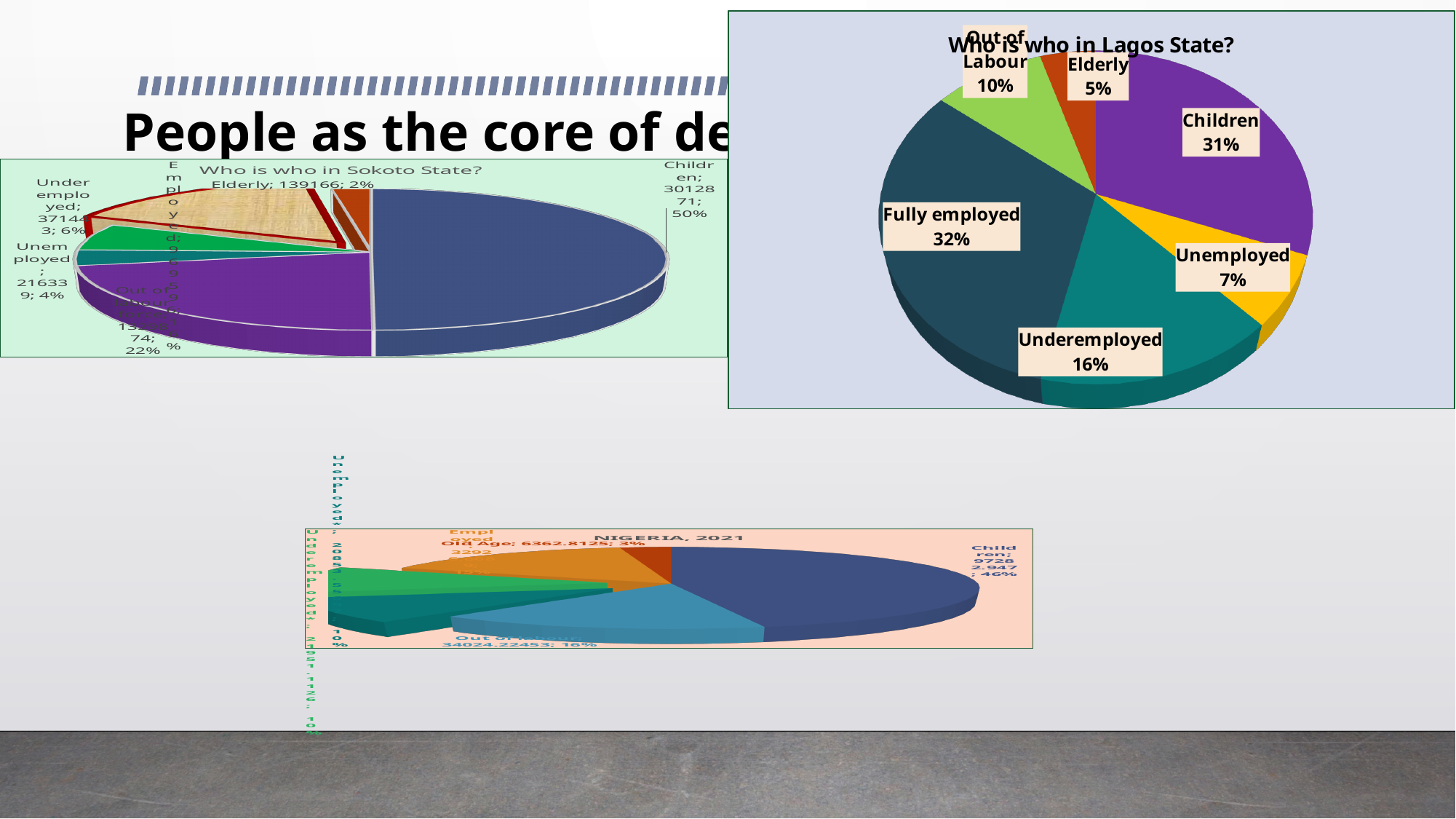
In the 'Who is who in Lagos State?' chart, what is the difference in percentage points between Fully employed and Underemployed? 16 In the 'Who is who in Lagos State?' chart, what share is labelled for Children? 31% In the 'Who is who in Lagos State?' chart, what share is labelled for Underemployed? 16% In the 'Who is who in Lagos State?' chart, which category has the smallest share? Elderly In the 'Who is who in Lagos State?' chart, which is larger, Out of Labour or Unemployed? Out of Labour In the 'NIGERIA, 2021' chart, what share is labelled for Children? 46% In the 'NIGERIA, 2021' chart, what value is labelled for Old Age? 6362.8125 In the 'Who is who in Lagos State?' chart, what share is labelled for Fully employed? 32% In the 'Who is who in Lagos State?' chart, how many categories are shown? 6 In the 'Who is who in Sokoto State?' chart, what value is labelled for Elderly? 139166 What kind of chart is 'Who is who in Lagos State?'? Pie chart In the 'Who is who in Sokoto State?' chart, what share is labelled for Children? 50%